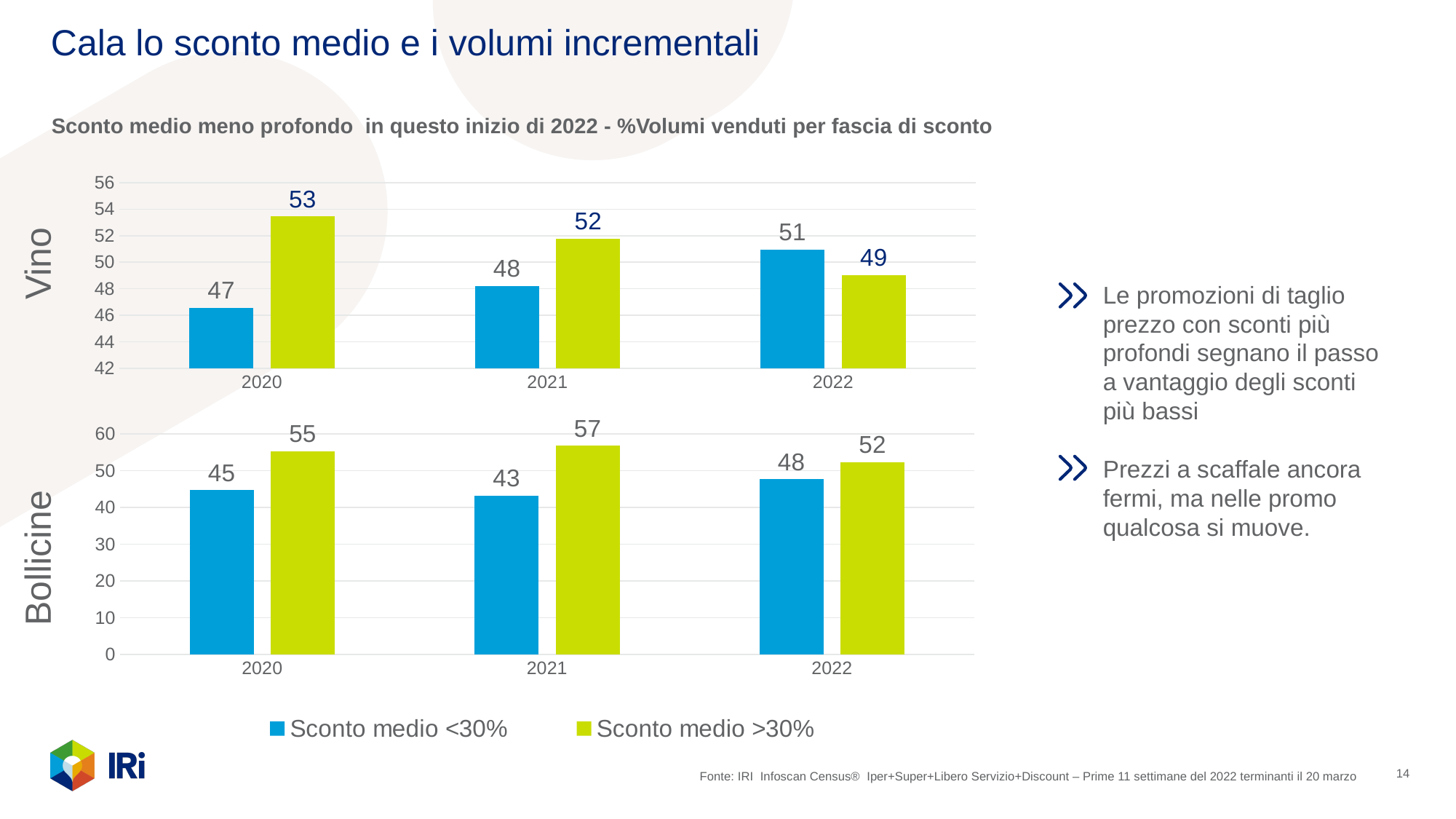
In the Vino chart, does the value for Sconto medio <30% rise or fall from 2020 to 2022? rise What kind of chart is the Bollicine chart? bar chart How many series does the legend list for the charts? 2 In the Vino chart, what is the difference between Sconto medio >30% and Sconto medio <30% in 2020? 6 In the Bollicine chart, what is the value for Sconto medio <30% in 2022? 48 In the Vino chart, which series is larger in 2022, Sconto medio <30% or Sconto medio >30%? Sconto medio <30% In the Vino chart, what is the value for Sconto medio <30% in 2020? 47 In the Bollicine chart, what is the difference between Sconto medio >30% and Sconto medio <30% in 2021? 14 In the Vino chart, what is the value for Sconto medio >30% in 2022? 49 In the Bollicine chart, which year has the lowest value for Sconto medio <30%? 2021 In the Vino chart, which year has the highest value for Sconto medio <30%? 2022 In the Bollicine chart, what is the value for Sconto medio >30% in 2021? 57